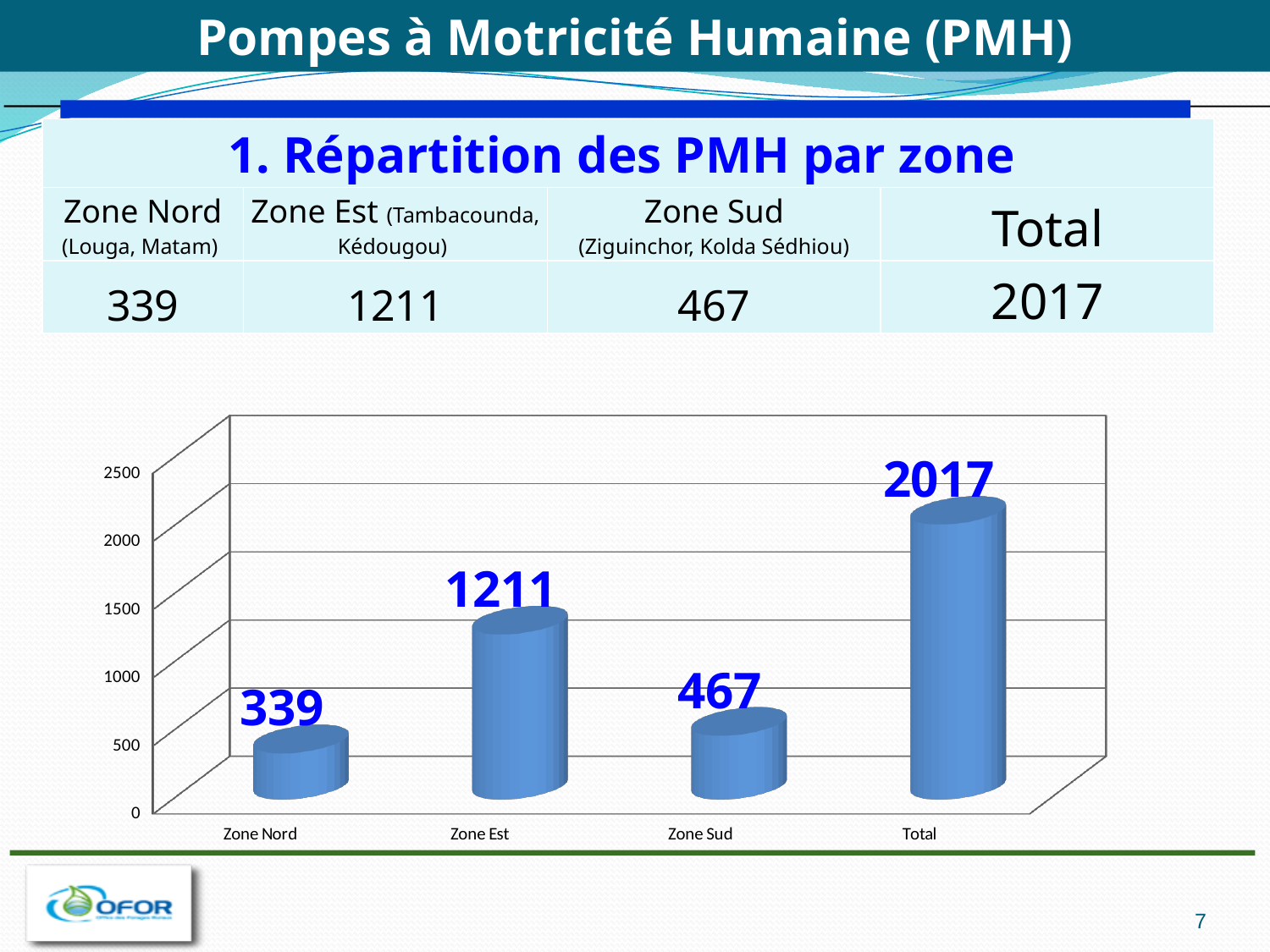
What is the value for Zone Nord? 339 What is the difference between the values for Zone Sud and Zone Nord? 128 Which is larger, the value for Zone Sud or the value for Zone Nord? Zone Sud What kind of chart is shown on the slide? bar chart What is the value for Zone Sud? 467 What is the value for Zone Est? 1211 Among the three zones (excluding Total), which has the highest value? Zone Est Which category has the lowest value? Zone Nord Which category has the highest value? Total How many categories are shown on the x axis? 4 What is the value for Total? 2017 What is the difference between the values for Zone Est and Zone Sud? 744